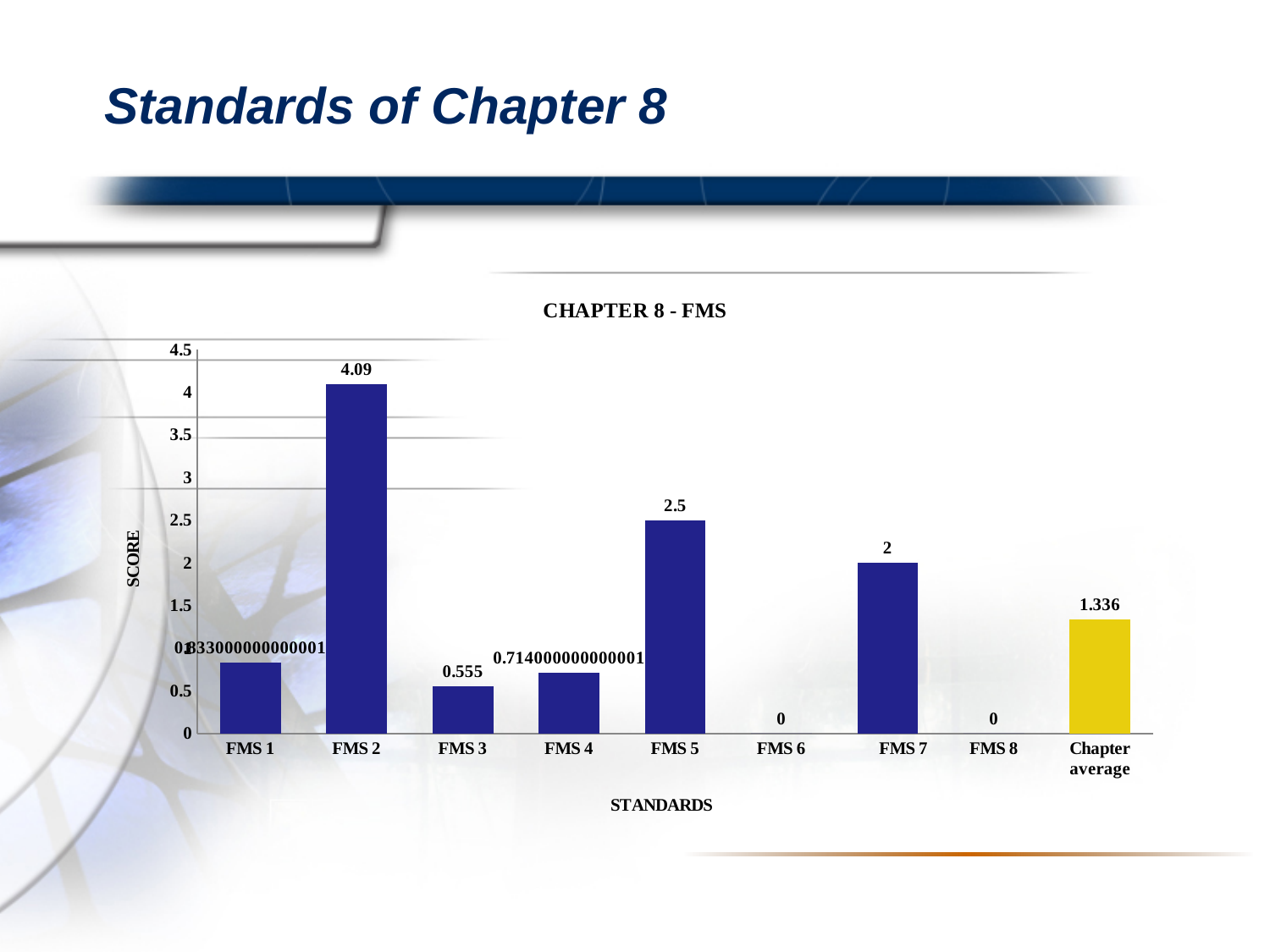
What is the value for FMS 5? 2.5 What is the label on the vertical axis of the chart? SCORE What is the value for FMS 3? 0.555 What is the Chapter average score shown in the chart? 1.336 What is the value for FMS 2 in the CHAPTER 8 - FMS chart? 4.09 Is the value for FMS 1 greater or less than 1? less How many categories are shown on the x axis of the chart? 9 What kind of chart is shown on the slide? bar chart Which is larger, the value for FMS 3 or FMS 4? FMS 4 What is the difference between the values for FMS 5 and FMS 7? 0.5 What is the difference between the values for FMS 2 and FMS 5? 1.59 Which standard has the highest score? FMS 2